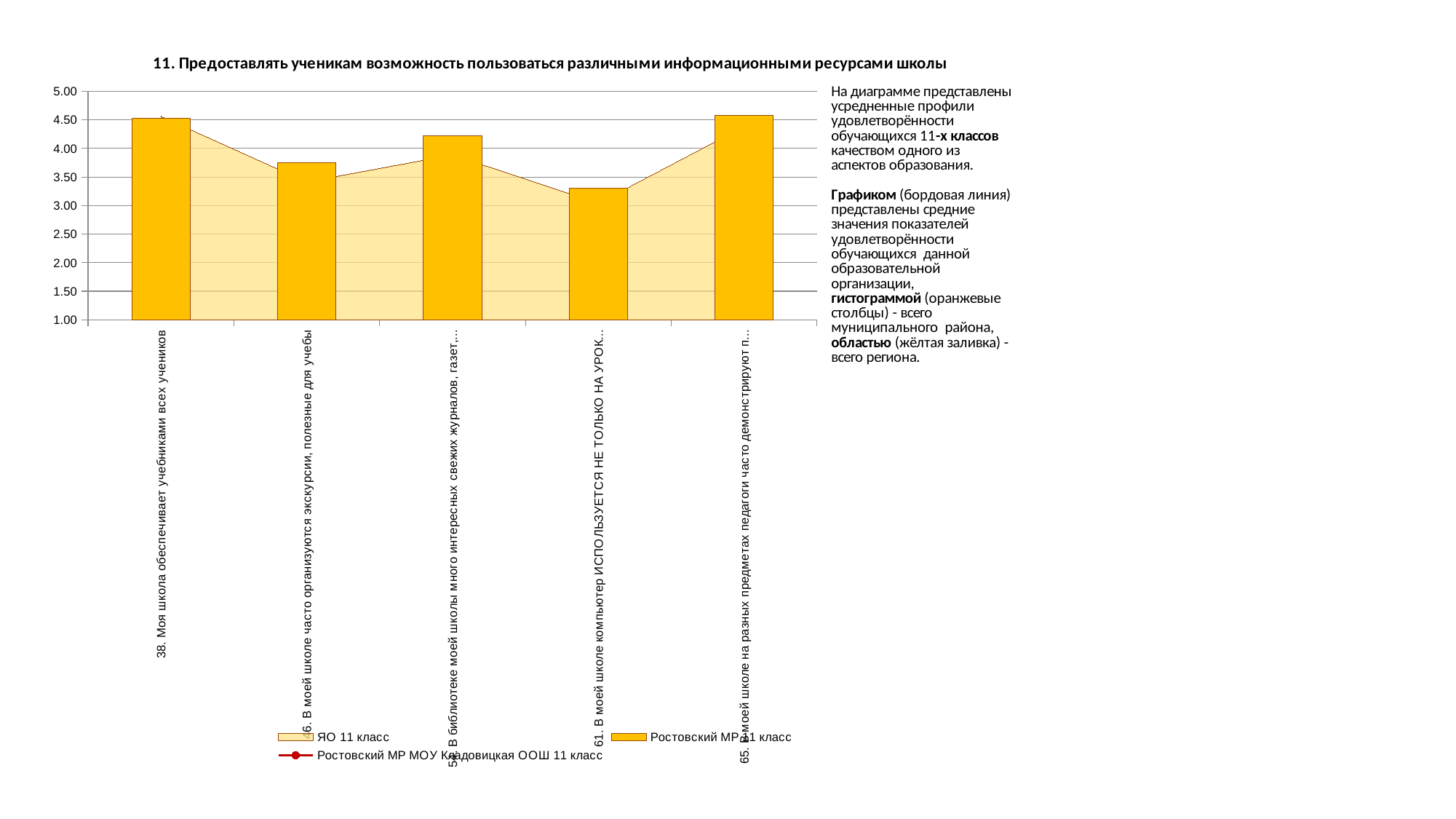
Which series is drawn as orange bars? Ростовский МР 11 класс Which category has the lowest orange bar (Ростовский МР 11 класс)? 61. В моей школе компьютер ИСПОЛЬЗУЕТСЯ НЕ ТОЛЬКО НА УРОК... Is the yellow area value (ЯО 11 класс) for statement 38 greater or less than 4.00? greater How many series does the chart legend list? 3 Which orange bar is taller: the one for statement 46 (excursions) or the one for statement 61 (computer use)? 46 Is the orange bar (Ростовский МР 11 класс) for the statement about excursions (46) greater or less than 3.50? greater Is the orange bar (Ростовский МР 11 класс) for statement 38 greater or less than 4.00? greater What is the title of the chart? 11. Предоставлять ученикам возможность пользоваться различными информационными ресурсами школы How many categories (statements) are shown along the x axis? 5